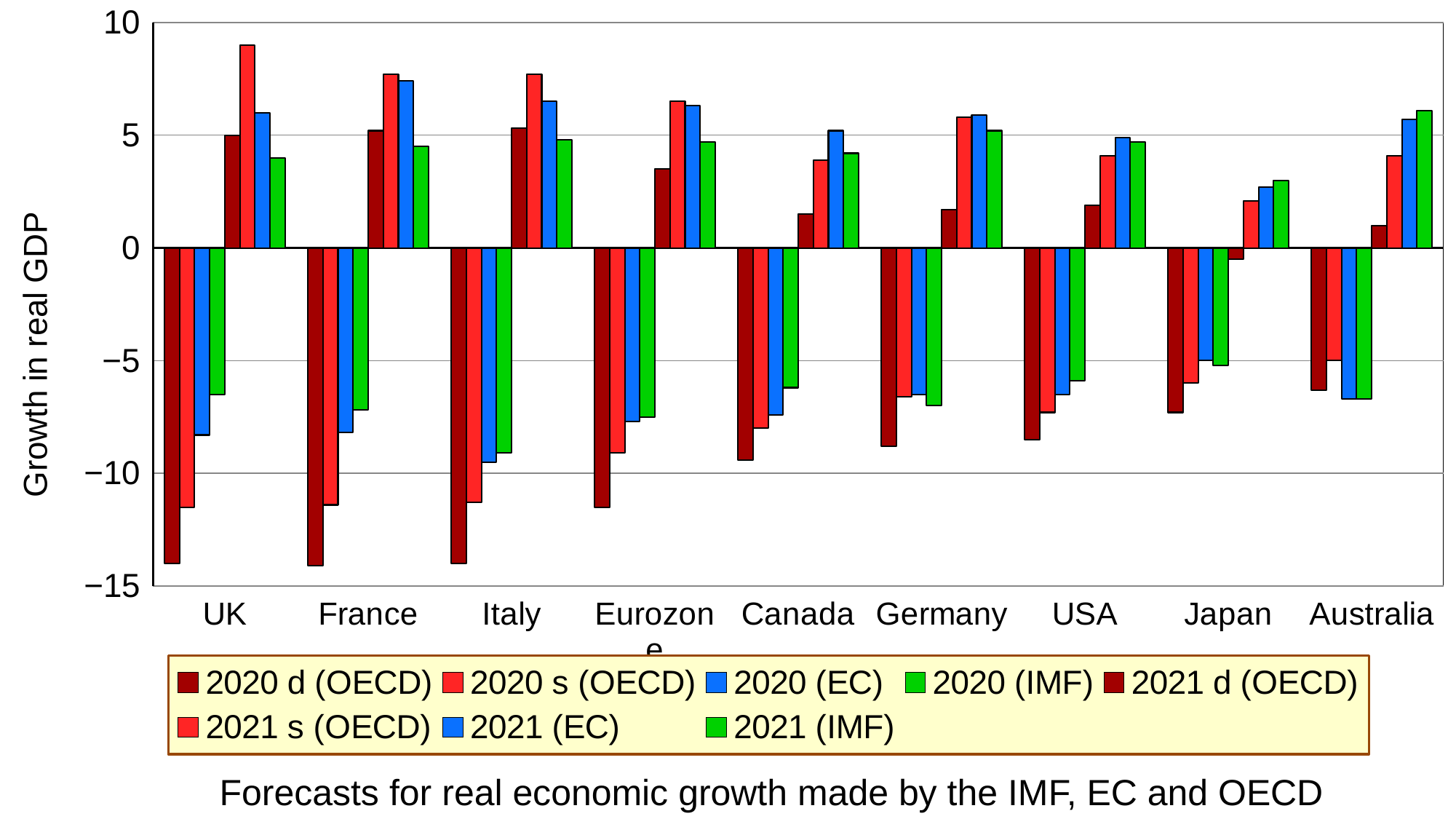
Is the 2020 s (OECD) value for the UK greater or less than 5? less Is the 2020 d (OECD) value for the UK greater or less than -10? less Which country or region has the lowest 2020 (EC) value? Italy Is the 2020 d (OECD) value for Japan greater or less than -5? less Which country or region has the highest 2021 (IMF) value? Australia Which is larger, the 2020 d (OECD) value for Japan or for Australia? Australia How many series does the legend list? 8 Which country or region has the highest 2020 s (OECD) value? Australia What is the label on the y axis? Growth in real GDP How many countries or regions are shown on the x axis? 9 What kind of chart is shown on the slide? bar chart